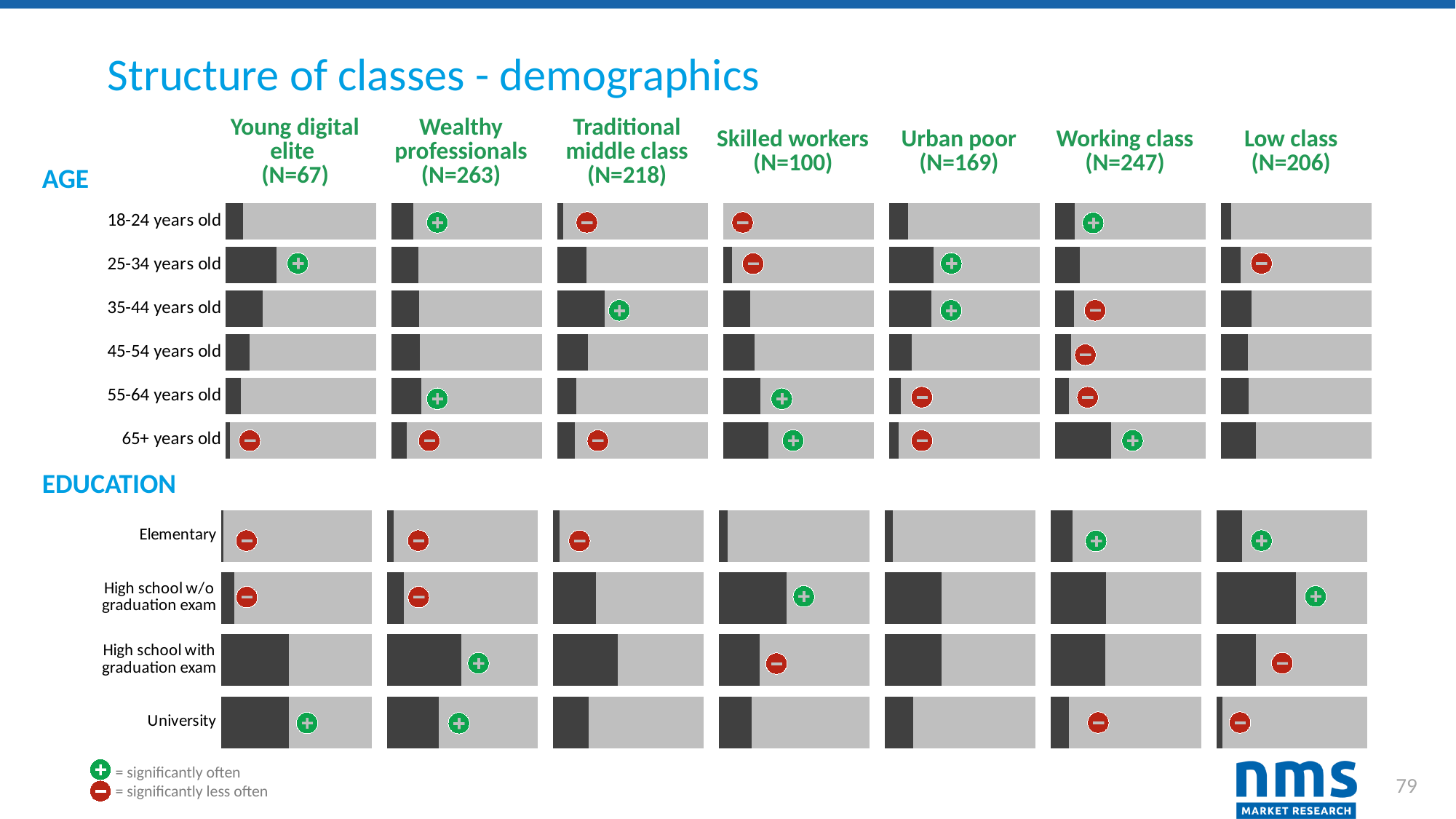
In the AGE section for Low class, which age group has the shortest bar? 18-24 years old What kind of chart is used to show the age and education distributions on this slide? Bar chart How many education categories are shown in the EDUCATION section? 4 How many classes (columns) are compared on the slide? 7 What is the sample size (N) shown for Wealthy professionals? N=263 In the AGE section for Urban poor, which bar is longer: 18-24 years old or 25-34 years old? 25-34 years old According to the legend, what does the green plus symbol mean? Significantly often In the AGE section for Young digital elite, which age group has the shortest bar? 65+ years old In the AGE section for Young digital elite, which age group has the longest bar? 25-34 years old How many age categories are shown in the AGE section? 6 In the EDUCATION section for Low class, which education level has the longest bar? High school w/o graduation exam In the AGE section for Working class, which age group has the longest bar? 65+ years old